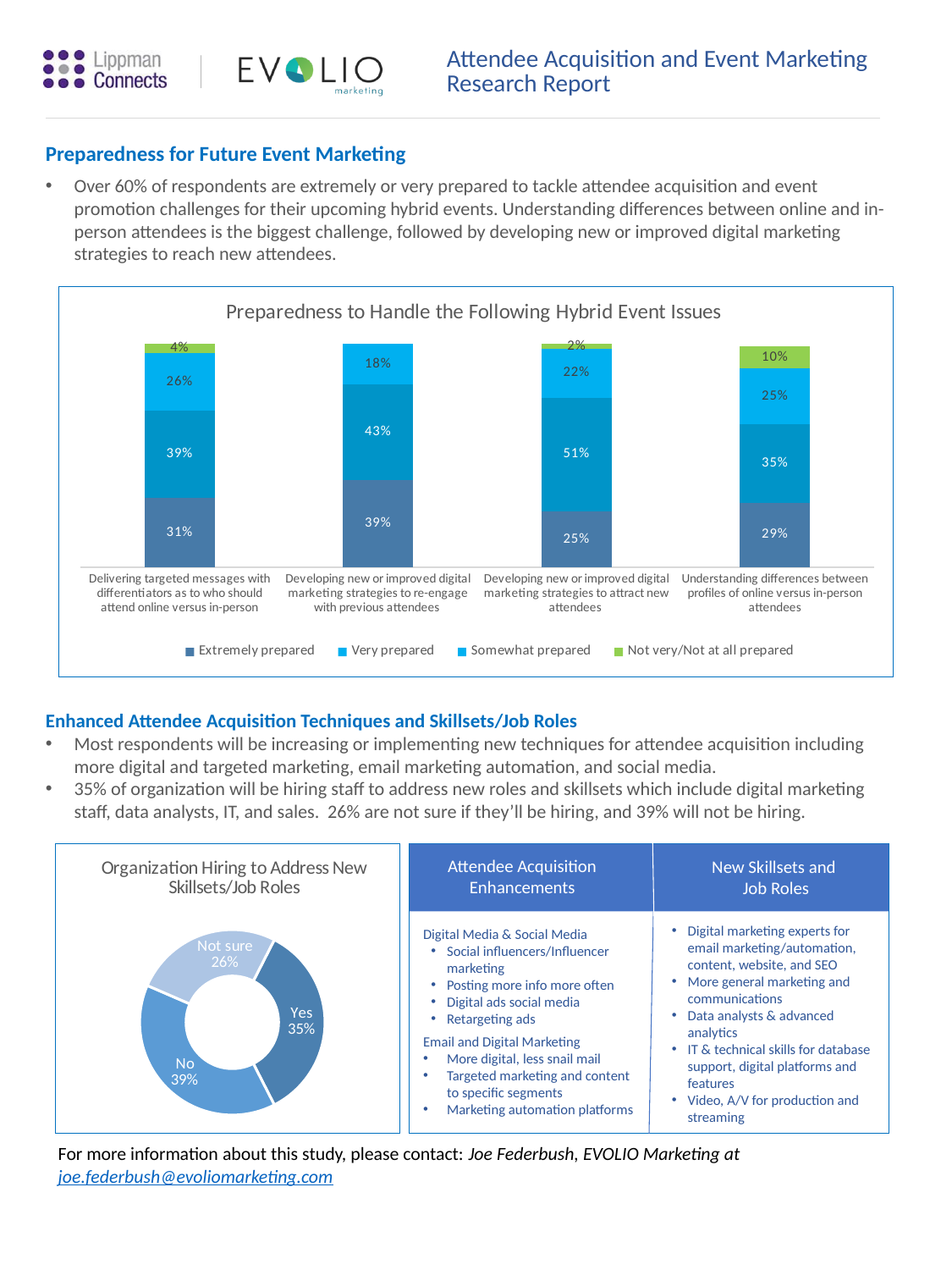
In the 'Organization Hiring to Address New Skillsets/Job Roles' chart, what percentage answered 'No'? 39% What kind of chart is 'Preparedness to Handle the Following Hybrid Event Issues'? Stacked bar chart In the 'Preparedness to Handle the Following Hybrid Event Issues' chart, what percentage are not very/not at all prepared for 'Understanding differences between profiles of online versus in-person attendees'? 10% In the 'Preparedness to Handle the Following Hybrid Event Issues' chart, what is the difference between the 'Very prepared' percentages for 'Developing new or improved digital marketing strategies to attract new attendees' and 'Understanding differences between profiles of online versus in-person attendees'? 16% In the 'Organization Hiring to Address New Skillsets/Job Roles' chart, which response has the smallest share? Not sure In the 'Preparedness to Handle the Following Hybrid Event Issues' chart, what percentage are very prepared for 'Developing new or improved digital marketing strategies to attract new attendees'? 51% In the 'Preparedness to Handle the Following Hybrid Event Issues' chart, which issue has the lowest 'Extremely prepared' percentage? Developing new or improved digital marketing strategies to attract new attendees In the 'Preparedness to Handle the Following Hybrid Event Issues' chart, what percentage of respondents are extremely prepared for 'Developing new or improved digital marketing strategies to re-engage with previous attendees'? 39% In the 'Preparedness to Handle the Following Hybrid Event Issues' chart, which issue has the highest 'Extremely prepared' percentage? Developing new or improved digital marketing strategies to re-engage with previous attendees In the 'Preparedness to Handle the Following Hybrid Event Issues' chart, how many hybrid event issues are shown on the x axis? 4 In the 'Preparedness to Handle the Following Hybrid Event Issues' chart, how many series does the legend list? 4 In the 'Organization Hiring to Address New Skillsets/Job Roles' chart, is the share for 'Yes' larger or smaller than the share for 'No'? Smaller